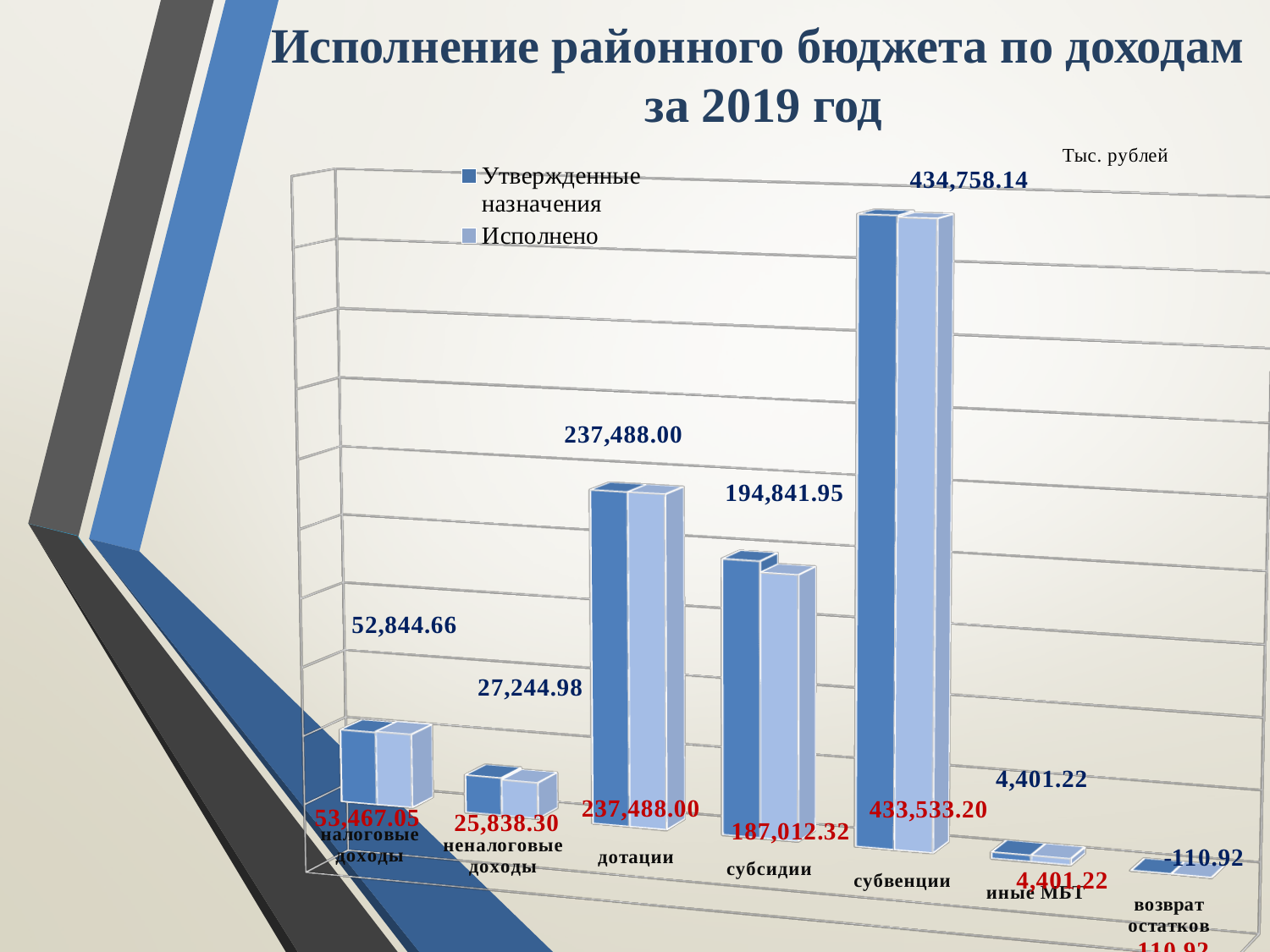
What is the difference between Утвержденные назначения and Исполнено for субсидии? 7,829.63 How many series does the legend list? 2 What unit is stated for the values in the chart? Тыс. рублей What is the value of Исполнено for субсидии? 187,012.32 What is the value of Утвержденные назначения for неналоговые доходы? 27,244.98 How many categories are shown on the x axis? 7 What is the value of Утвержденные назначения for субвенции? 434,758.14 What kind of chart is shown on the slide? bar chart Which category has the lowest value for Исполнено? возврат остатков Which category has the highest value for Утвержденные назначения? субвенции Which is larger for неналоговые доходы: Утвержденные назначения or Исполнено? Утвержденные назначения What is the value of Исполнено for налоговые доходы? 53,467.05